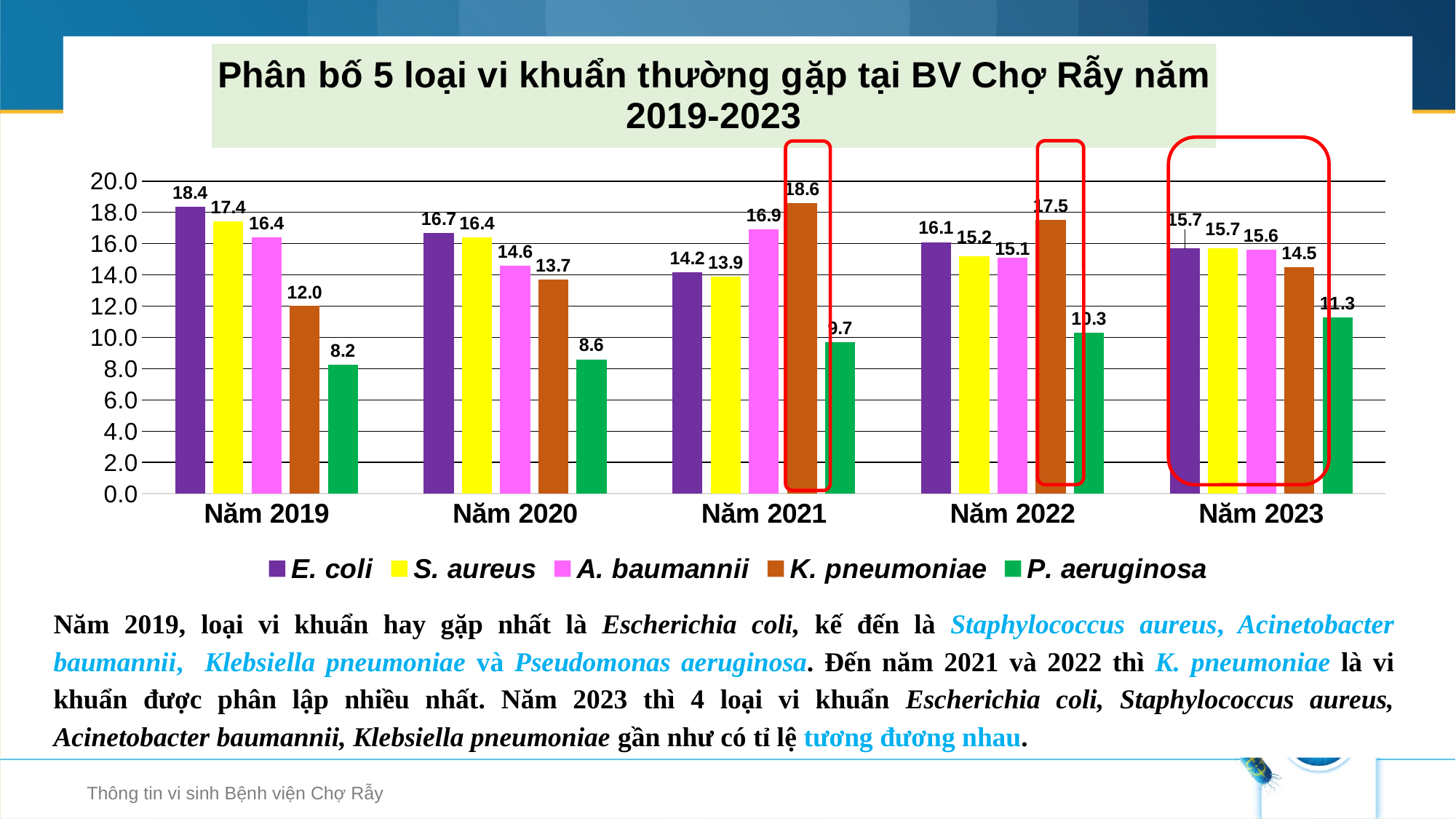
How many series does the legend list? 5 What is the value for K. pneumoniae in Năm 2021? 18.6 What colour are the bars for K. pneumoniae? brown How many year categories are shown on the x axis? 5 Which series has the lowest value in Năm 2023? P. aeruginosa Which series has the highest value in Năm 2019? E. coli What kind of chart is shown on the slide? bar chart What is the difference between the K. pneumoniae value and the E. coli value in Năm 2022? 1.4 What is the value for P. aeruginosa in Năm 2019? 8.2 Which is larger in Năm 2021: the value for E. coli or the value for A. baumannii? A. baumannii What is the value for A. baumannii in Năm 2020? 14.6 Does the value for P. aeruginosa rise or fall from Năm 2019 to Năm 2023? rise